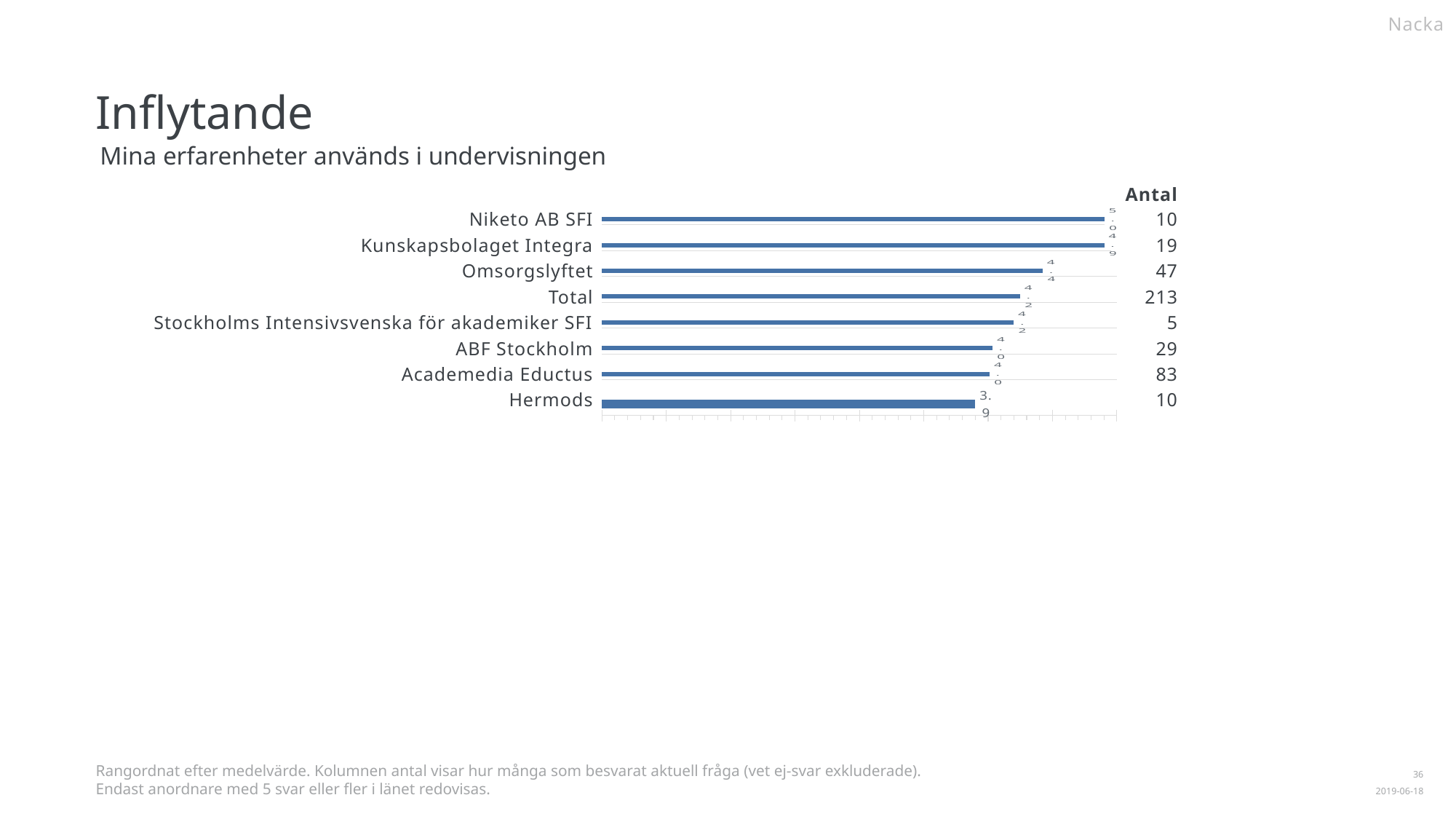
Which category has the shortest bar in the chart? Hermods What kind of chart is shown on the slide? bar chart Which has the larger value, Niketo AB SFI or Hermods? Niketo AB SFI Which category has the longest bar in the chart? Niketo AB SFI What is the Antal (number of respondents) shown for Total? 213 How many categories (bars) does the chart show? 8 What is the subtitle of the chart below the heading 'Inflytande'? Mina erfarenheter används i undervisningen What is the value shown for Hermods? 3.9 What is the value shown for Omsorgslyftet? 4.4 What is the value shown for Niketo AB SFI? 5.0 What is the difference between the values for Niketo AB SFI and Hermods? 1.1 Which has the larger value, Kunskapsbolaget Integra or Academedia Eductus? Kunskapsbolaget Integra